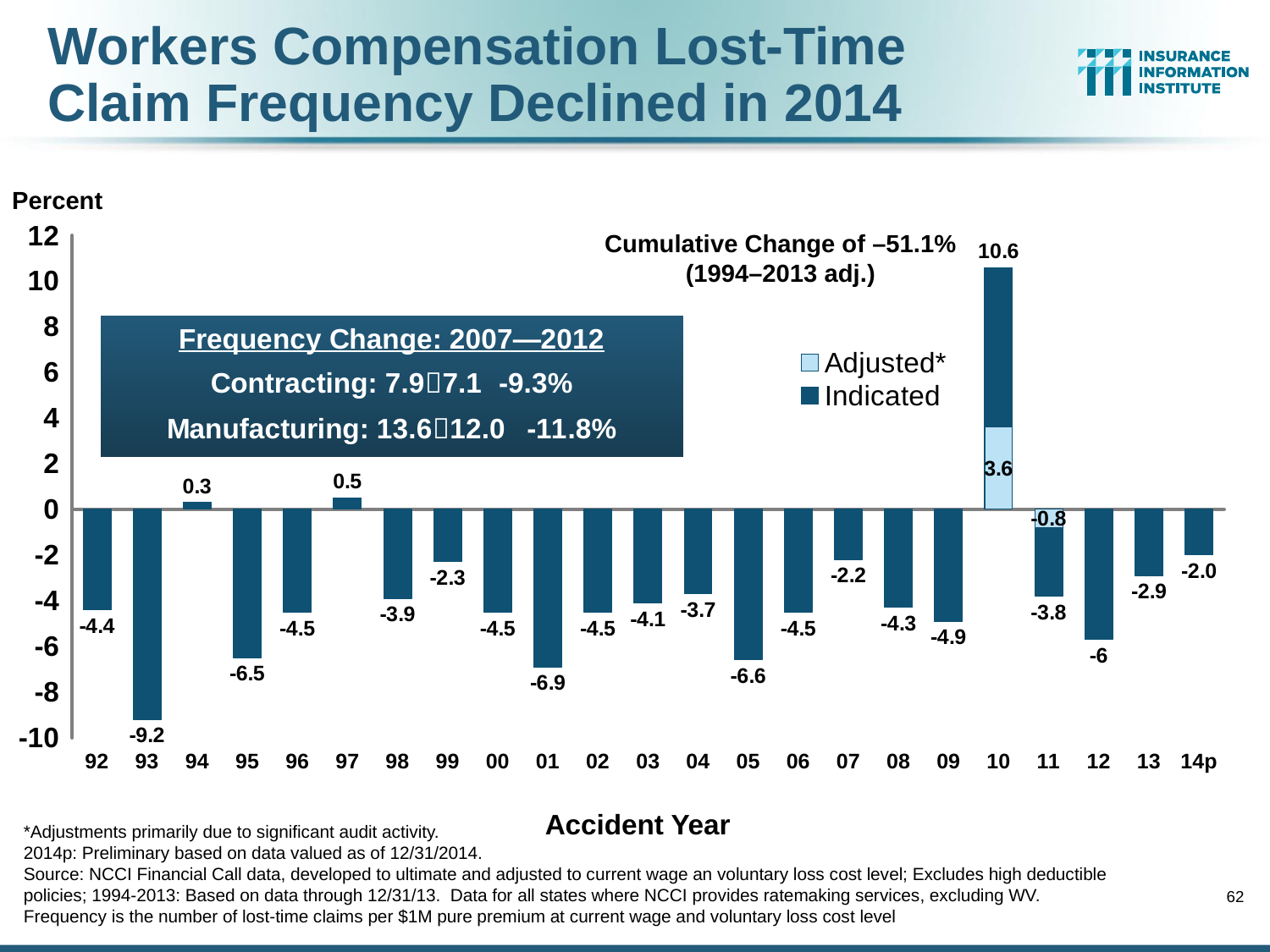
What is the label of the x axis? Accident Year What is the Adjusted value for accident year 10? 3.6 What is the Indicated value for accident year 10? 10.6 Which accident year has the lowest value on the chart? 93 What is the value for accident year 2014p? -2.0 Which accident year has the larger value, 01 or 05? 05 How many series does the legend list? 2 Which accident year has the highest value on the chart? 10 What is the difference between the values for accident years 12 and 13? 3.1 How many accident years are shown on the x axis? 23 What is the value for accident year 93? -9.2 What kind of chart is shown on the slide? Bar chart